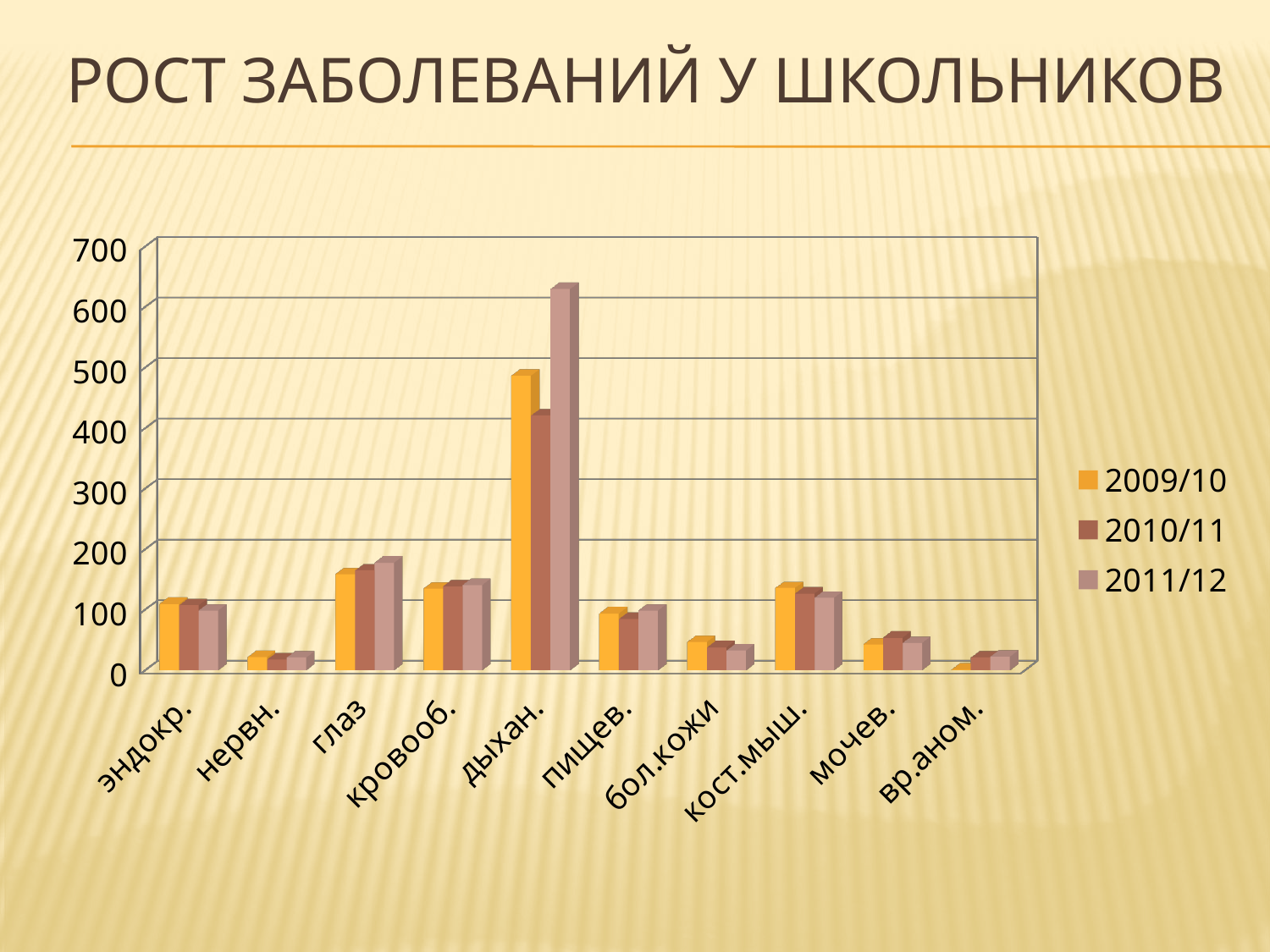
Which category has the highest value for the 2009/10 series? дыхан. Is the 2011/12 value for глаз greater or less than 100? greater What is the title of the slide containing the chart? РОСТ ЗАБОЛЕВАНИЙ У ШКОЛЬНИКОВ How many series does the legend list? 3 Which category has the highest value for the 2011/12 series? дыхан. What type of chart is shown on the slide? bar chart For the 2009/10 series, which is larger: кост.мыш. or пищев.? кост.мыш. For дыхан., which series has the larger value: 2009/10 or 2011/12? 2011/12 Which category has the lowest value for the 2009/10 series? вр.аном. Is the 2011/12 value for дыхан. greater or less than 600? greater Is the 2009/10 value for нервн. greater or less than 100? less How many categories are shown on the x axis of the chart? 10